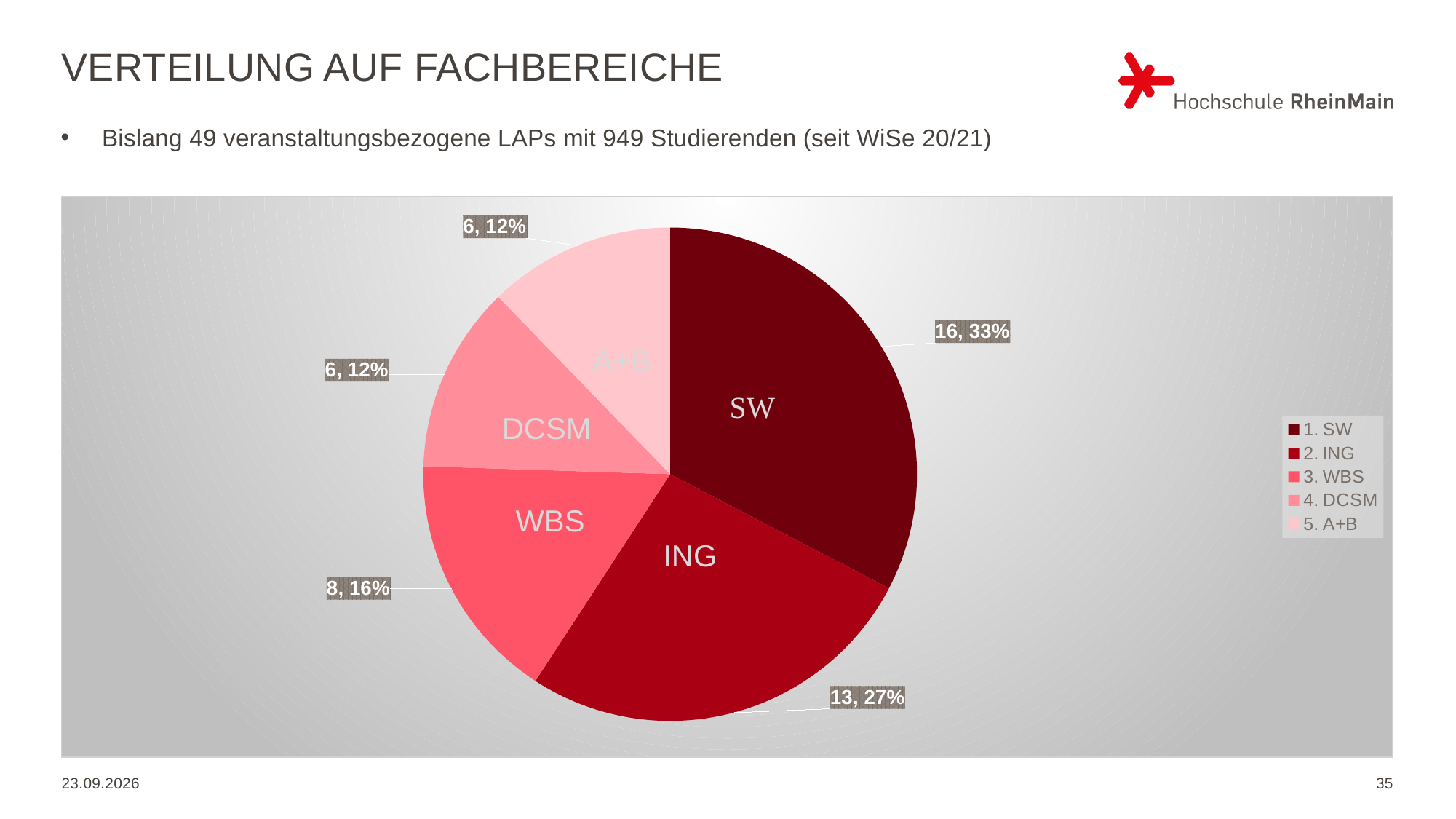
What is the value for ING? 13 What is the value for SW? 16 How many entries does the legend list? 5 Which category has the largest slice? SW How many slices does the pie chart have? 5 What is the difference between the values for SW and ING? 3 What is the total of all slice values in the pie chart? 49 What share of the pie does SW represent? 33% Which is larger, the value for ING or the value for WBS? ING What kind of chart is shown on the slide? pie chart What share of the pie does WBS represent? 16% What is the value for WBS? 8